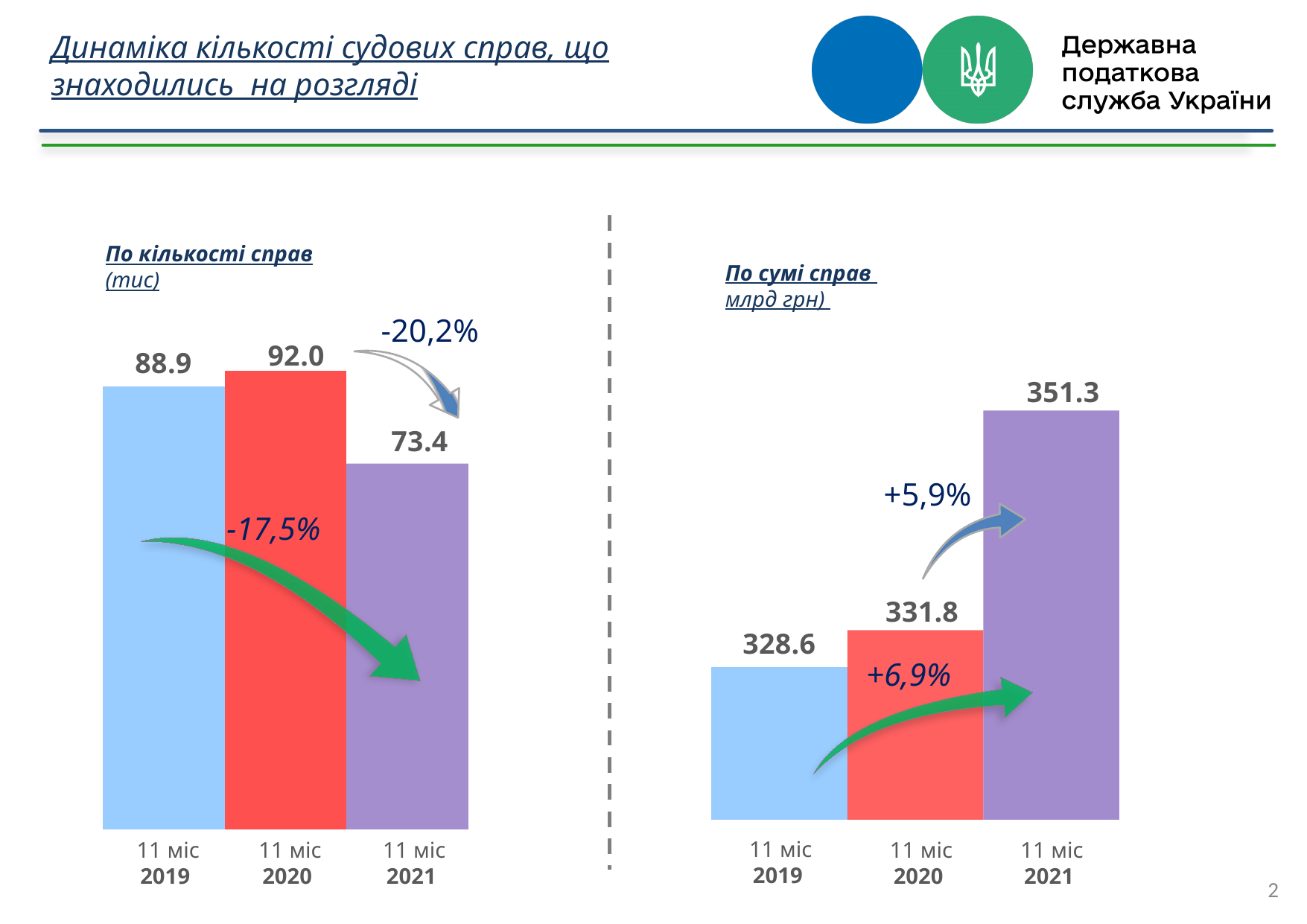
In the right chart (По сумі справ), what is the value for 11 міс 2019? 328.6 In the right chart (По сумі справ), which is larger: the value for 11 міс 2020 or 11 міс 2021? 11 міс 2021 In the left chart (По кількості справ), what is the value for 11 міс 2021? 73.4 In the left chart (По кількості справ), which period has the highest value? 11 міс 2020 How many bars are shown in the left chart (По кількості справ)? 3 What type of chart is used on the right side of the slide (По сумі справ)? Bar chart In the left chart (По кількості справ), which period has the lowest value? 11 міс 2021 In the right chart (По сумі справ), what is the difference between the values for 11 міс 2021 and 11 міс 2019? 22.7 In the right chart (По сумі справ), what is the value for 11 міс 2021? 351.3 In the left chart (По кількості справ), what is the value for 11 міс 2020? 92.0 In the right chart (По сумі справ), which period has the highest value? 11 міс 2021 In the left chart (По кількості справ), what is the difference between the values for 11 міс 2020 and 11 міс 2021? 18.6